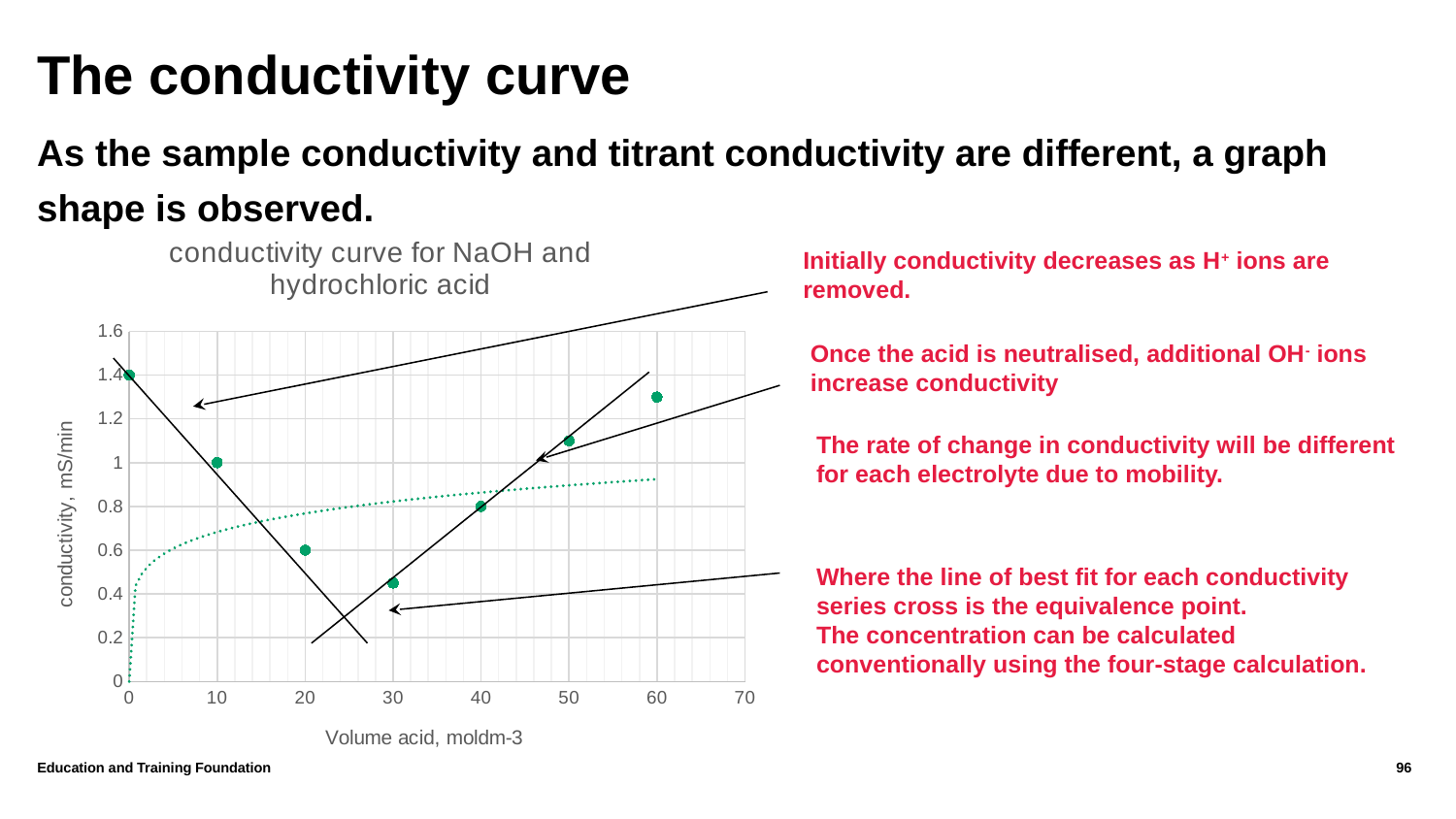
What is the title of the chart? conductivity curve for NaOH and hydrochloric acid How many data points are plotted on the chart? 7 What is the conductivity value at a volume of acid of 20? 0.6 What is the conductivity value at a volume of acid of 0? 1.4 Which has the higher conductivity: the point at volume 10 or the point at volume 50? volume 50 What kind of chart is shown on the slide? scatter chart At which volume of acid is the plotted conductivity highest? 0 What is the label of the y axis of the chart? conductivity, mS/min What is the conductivity value at a volume of acid of 10? 1 What is the conductivity value at a volume of acid of 40? 0.8 Is the conductivity value at a volume of acid of 60 greater or less than 1.2? greater At which volume of acid is the plotted conductivity lowest? 30